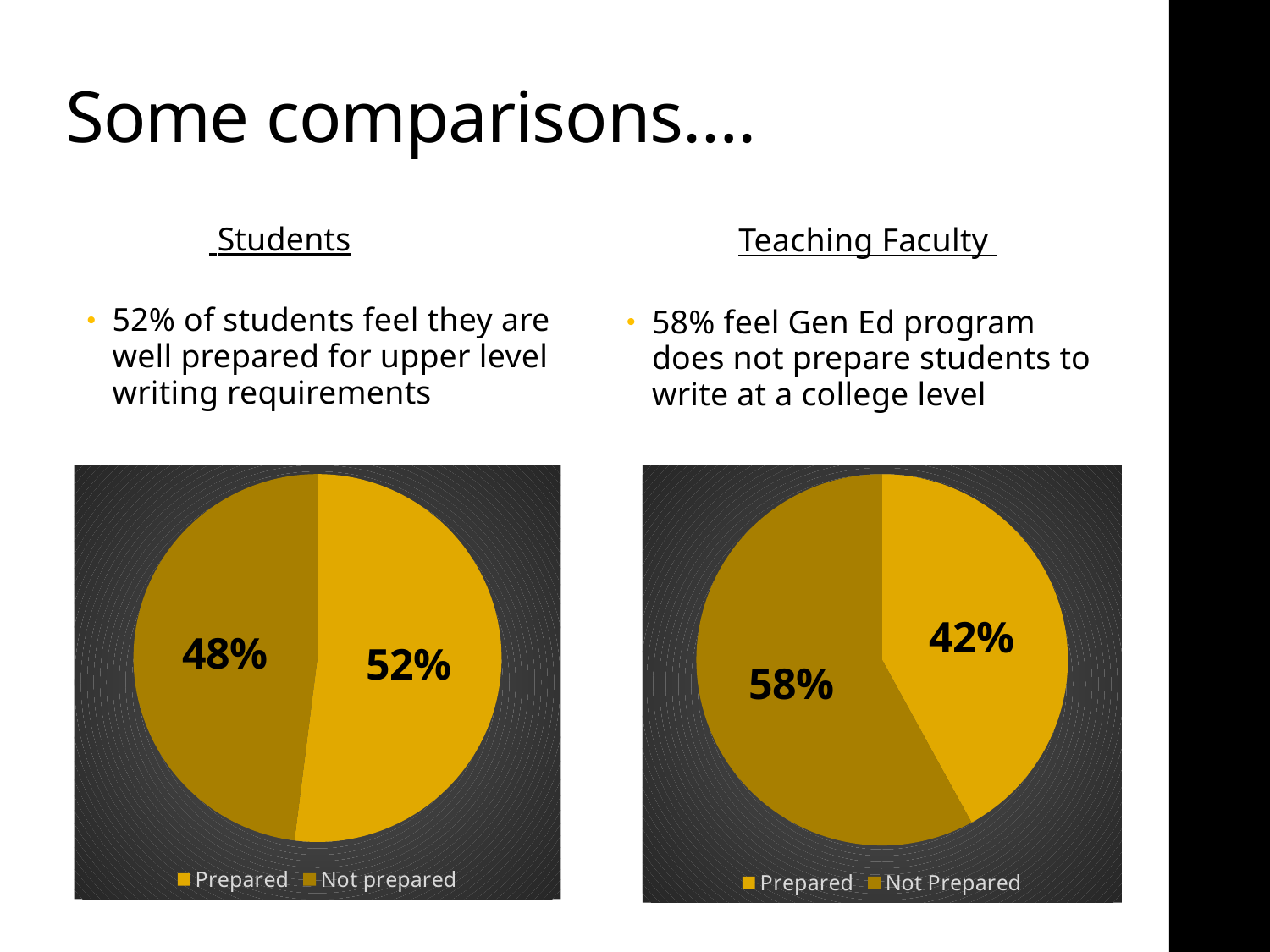
In the left pie chart (Students), what share of the pie is labelled Prepared? 52% In the right pie chart (Teaching Faculty), what share of the pie is labelled Not Prepared? 58% In the right pie chart (Teaching Faculty), which slice is the smallest? Prepared In the left pie chart (Students), what is the difference in percentage points between the Prepared and Not prepared slices? 4 How many slices does the left pie chart (Students) have? 2 In the right pie chart (Teaching Faculty), what share of the pie is labelled Prepared? 42% What kind of chart is shown under the Students heading on the left? pie chart How many entries does the legend of the right pie chart (Teaching Faculty) list? 2 In the right pie chart (Teaching Faculty), which slice is the largest? Not Prepared In the left pie chart (Students), which slice is larger, Prepared or Not prepared? Prepared In the left pie chart (Students), what share of the pie is labelled Not prepared? 48% In the right pie chart (Teaching Faculty), what is the difference in percentage points between the Not Prepared and Prepared slices? 16